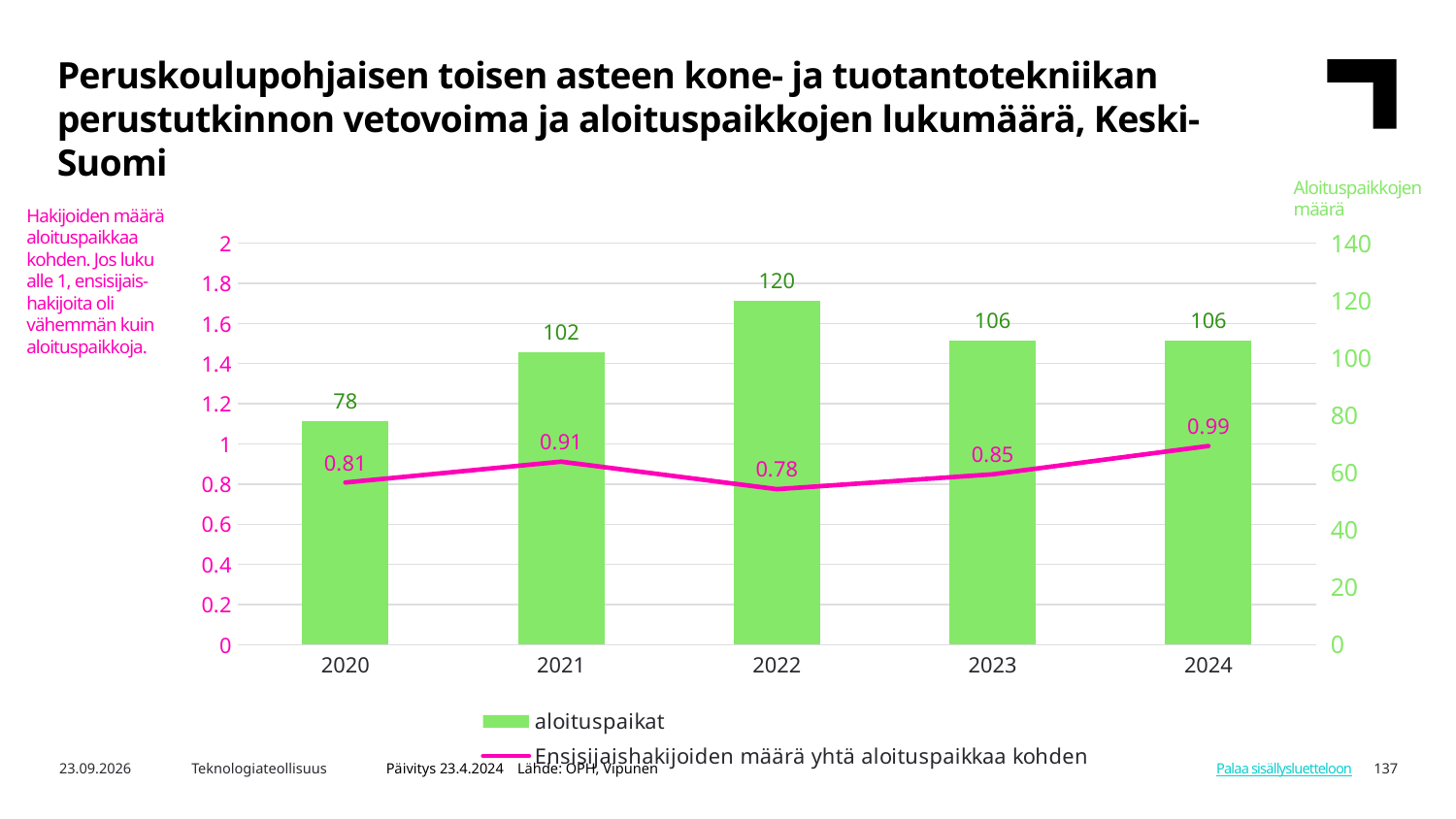
How many years are shown on the x axis of the chart? 5 Is the aloituspaikat value for 2021 greater or less than 100? greater What is the value of aloituspaikat for 2020? 78 What is the value of Ensisijaishakijoiden määrä yhtä aloituspaikkaa kohden for 2024? 0.99 Which year has the lowest value of Ensisijaishakijoiden määrä yhtä aloituspaikkaa kohden? 2022 What colour are the aloituspaikat bars in the chart? green What is the difference in aloituspaikat between 2022 and 2020? 42 Which is larger, the Ensisijaishakijoiden määrä yhtä aloituspaikkaa kohden value for 2021 or for 2023? 2021 Which year has the highest value of aloituspaikat? 2022 How many series does the chart legend list? 2 Does the Ensisijaishakijoiden määrä yhtä aloituspaikkaa kohden line rise or fall from 2023 to 2024? rise What is the value of aloituspaikat for 2022? 120